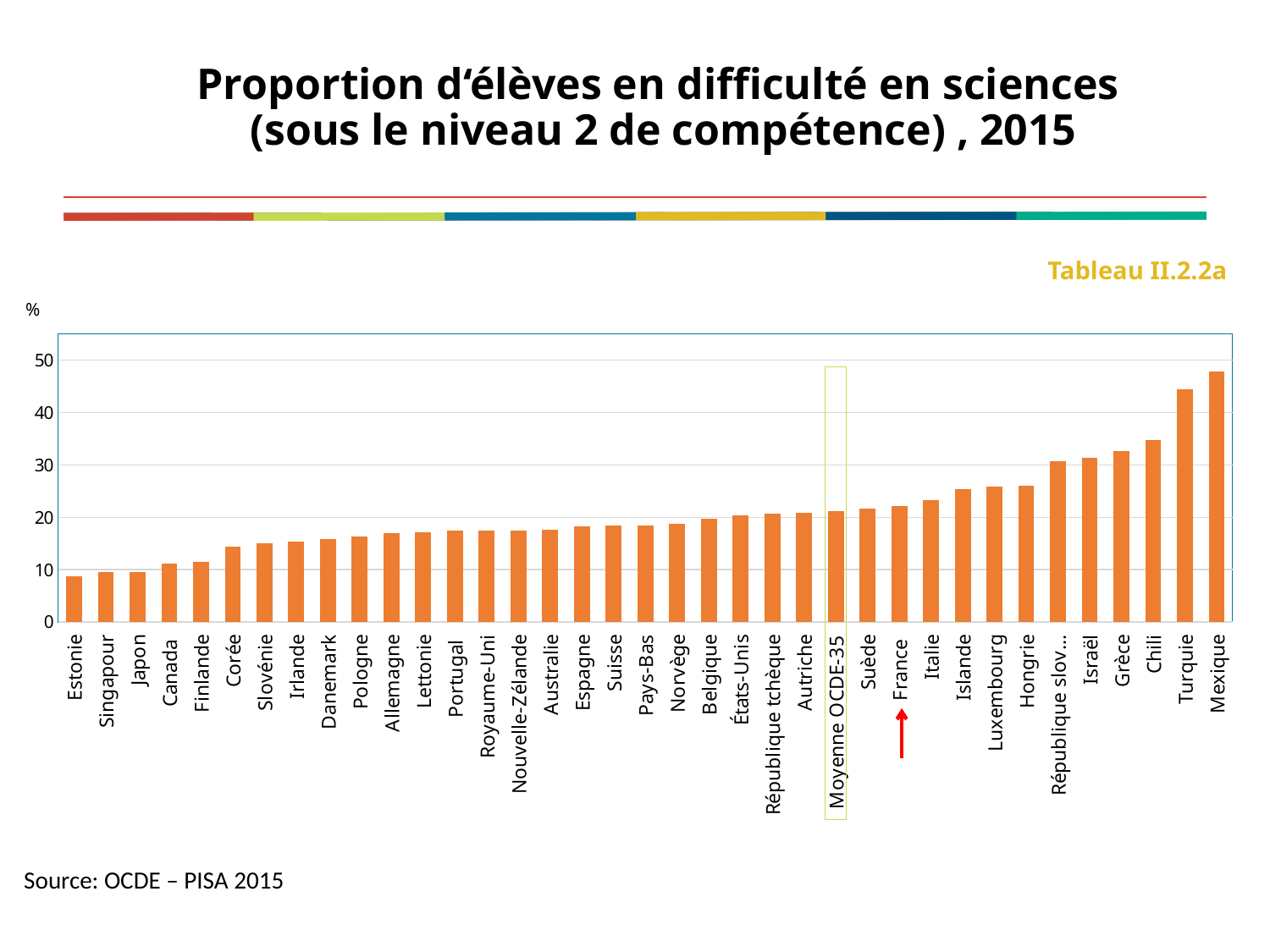
What kind of chart is shown on the slide? bar chart What is the source cited at the bottom of the slide? OCDE – PISA 2015 Do the values rise or fall from left to right along the x axis? rise Is the value for Chili greater or less than 30? greater Is the value for Mexique greater or less than 40? greater Which category has the highest value on the chart? Mexique Is the value for France greater or less than 20? greater How many categories (bars) are plotted on the chart? 37 Which is larger, the value for Turquie or the value for Chili? Turquie Which category on the chart is marked with a red arrow? France